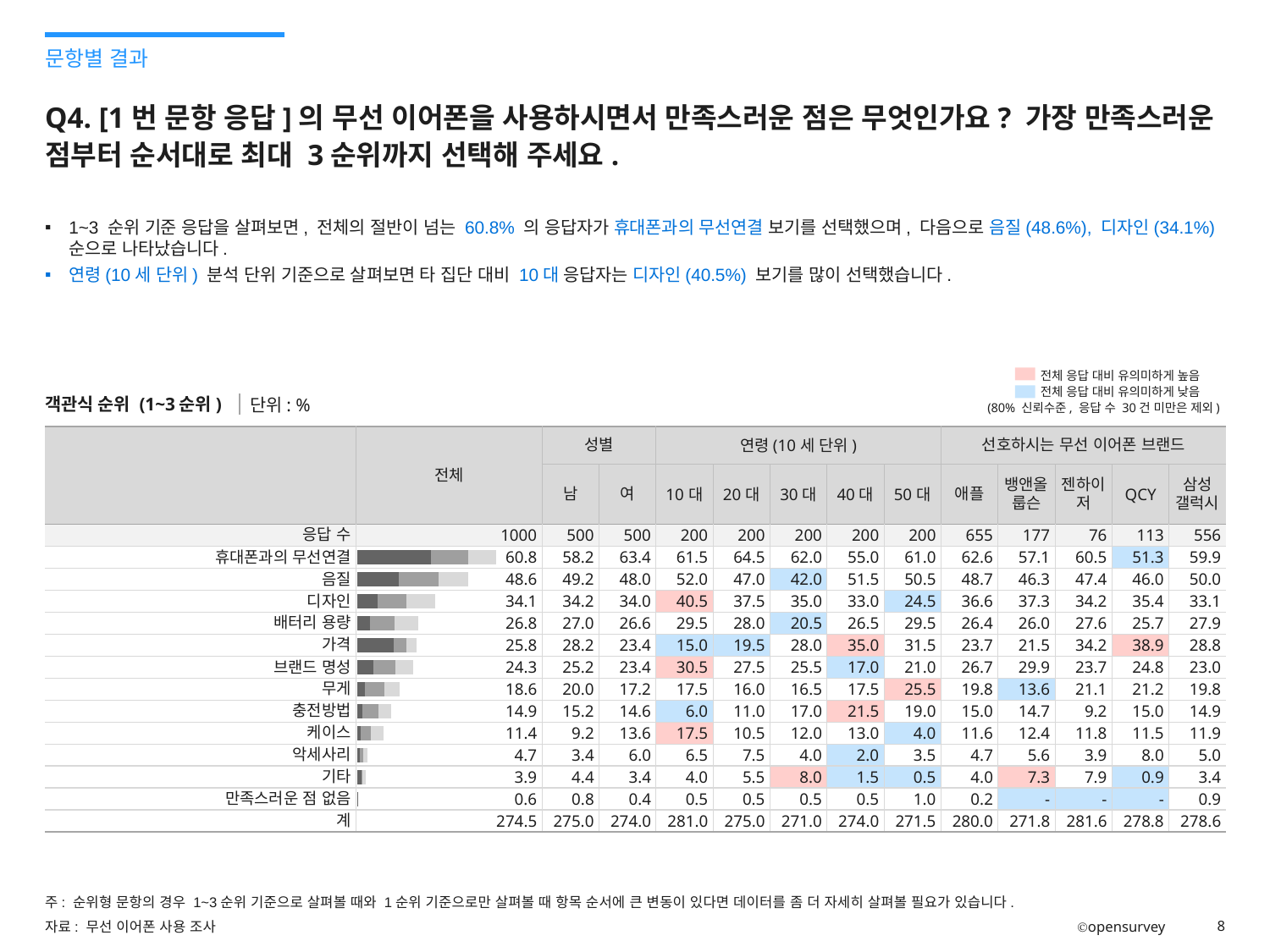
Which category has the highest overall (전체) value? 휴대폰과의 무선연결 What is the overall (전체) value for 디자인? 34.1 Which has a larger overall (전체) value, 배터리 용량 or 가격? 배터리 용량 What is the overall (전체) value for 음질? 48.6 What is the overall (전체) value for 휴대폰과의 무선연결? 60.8 How many response categories (excluding 응답 수 and 계) are listed in the table? 12 What is the overall (전체) value for 10대 respondents for 디자인? 40.5 What kind of chart is embedded in the 전체 column of the table? bar chart What unit is stated for the values in the table? % Which category has the lowest overall (전체) value? 만족스러운 점 없음 Do the overall (전체) values rise or fall going down the list of categories from 휴대폰과의 무선연결 to 만족스러운 점 없음? fall What is the difference between the overall (전체) values for 휴대폰과의 무선연결 and 음질? 12.2